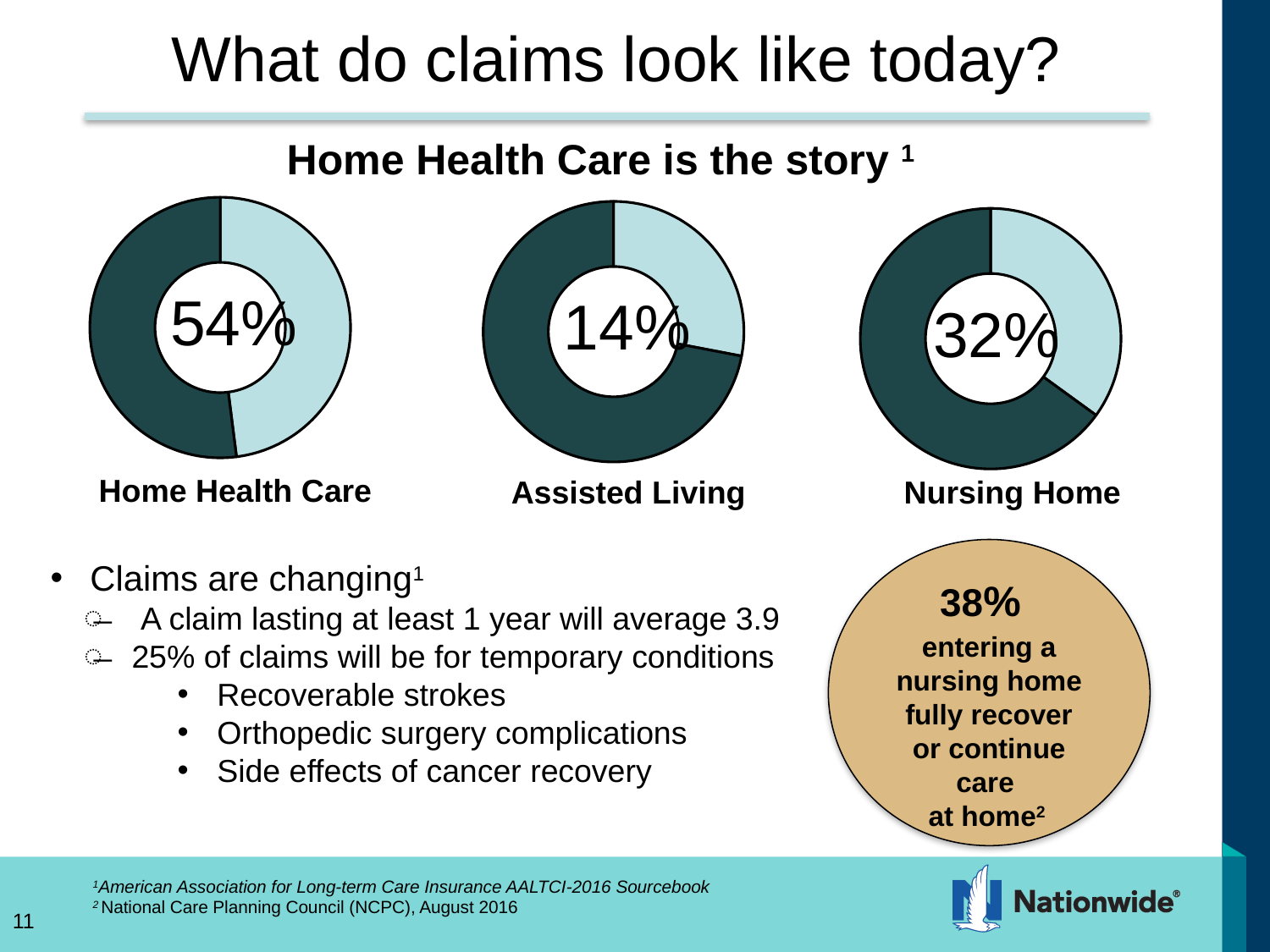
Which is larger, the Nursing Home percentage or the Assisted Living percentage? Nursing Home What percentage is shown in the Nursing Home donut chart? 32% What percentage is shown in the Home Health Care donut chart? 54% What is the heading above the three donut charts? Home Health Care is the story Which of the three care categories has the lowest percentage of claims? Assisted Living What is the difference in percentage points between Home Health Care and Nursing Home? 22 What do the three donut chart percentages add up to? 100% What percentage is shown in the Assisted Living donut chart? 14% Which of the three care categories has the highest percentage of claims? Home Health Care How many donut charts are shown on the slide? 3 What type of chart is used to show the claim percentages for each care category? Donut (pie) chart What is the difference in percentage points between Nursing Home and Assisted Living? 18